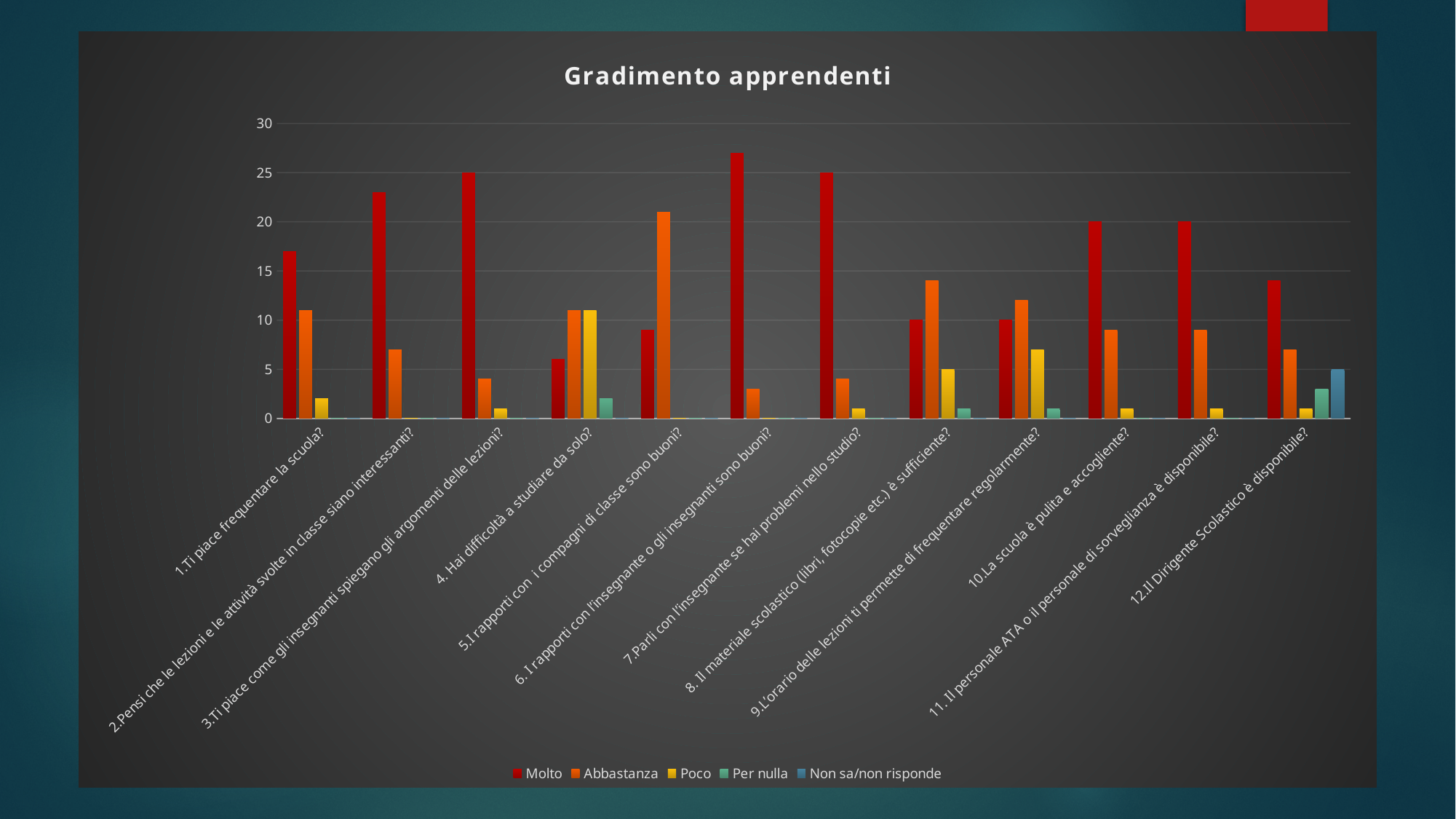
How many question categories are shown on the x axis? 12 What is the value of Non sa/non risponde for question 12 (Il Dirigente Scolastico è disponibile?)? 5 Which question has the lowest Molto value? 4. Hai difficoltà a studiare da solo? Is the Molto value for question 2 (Pensi che le lezioni e le attività svolte in classe siano interessanti?) greater or less than 20? greater What is the value of Molto for question 3 (Ti piace come gli insegnanti spiegano gli argomenti delle lezioni?)? 25 How many series does the legend list? 5 Is the Abbastanza value for question 9 (L'orario delle lezioni ti permette di frequentare regolarmente?) greater or less than 10? greater What is the value of Molto for question 10 (La scuola è pulita e accogliente?)? 20 Which question has the highest Molto value? 6. I rapporti con l'insegnante o gli insegnanti sono buoni? For question 5 (I rapporti con i compagni di classe sono buoni?), which is larger: Molto or Abbastanza? Abbastanza What type of chart is shown on the slide? bar chart What is the title of the chart? Gradimento apprendenti